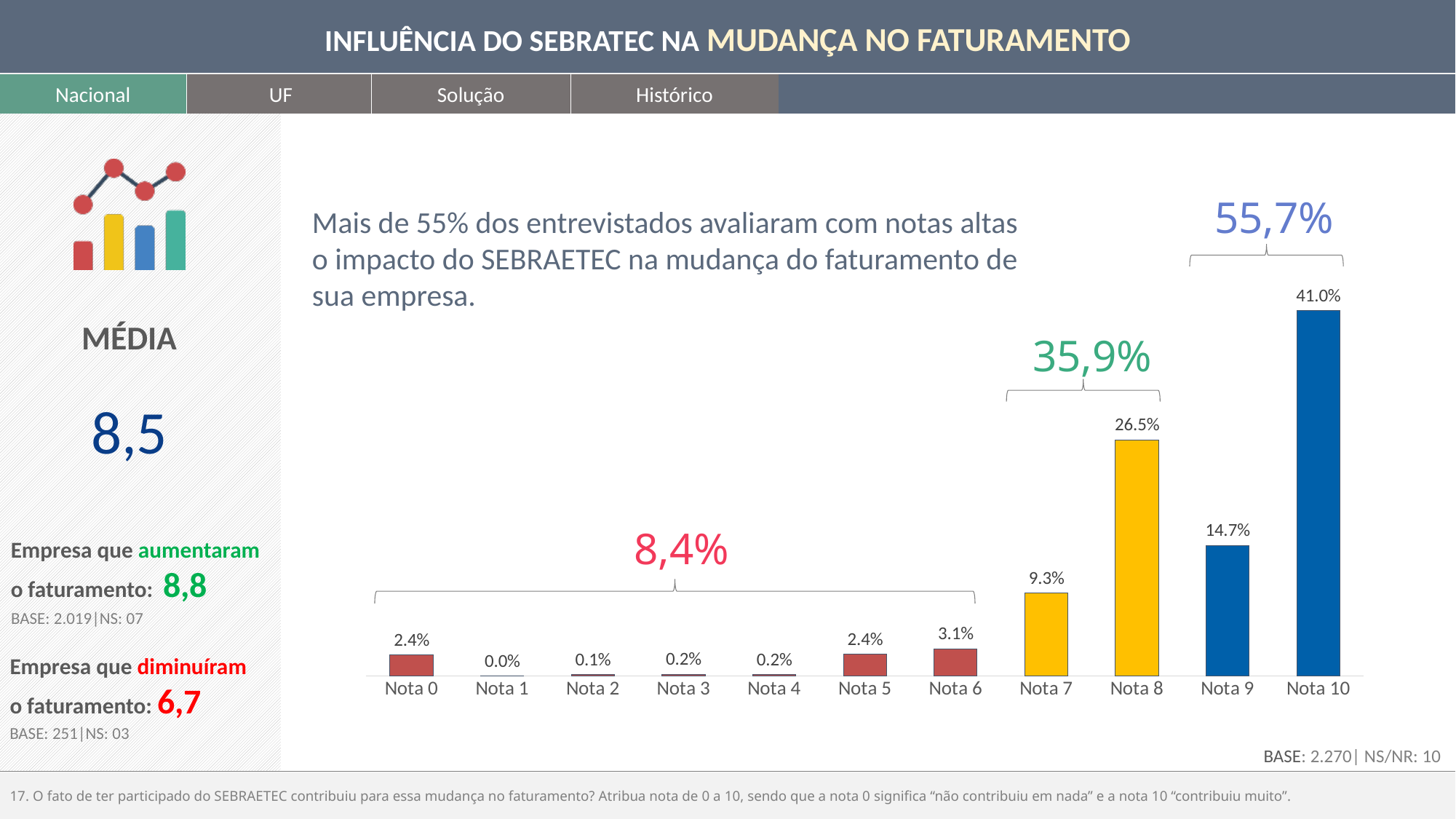
What combined percentage is shown above the bracket covering Nota 9 and Nota 10? 55,7% How many categories are shown on the x axis? 11 What is the value for Nota 7? 9.3% Which category has the lowest value? Nota 1 What combined percentage is shown above the bracket covering Nota 0 to Nota 6? 8,4% What is the difference between the values for Nota 10 and Nota 8? 14.5% Which is larger, the value for Nota 9 or the value for Nota 8? Nota 8 Which category has the highest value? Nota 10 What is the value for Nota 1? 0.0% What is the value for Nota 8? 26.5% What kind of chart is shown on the slide? Bar chart What is the value for Nota 10? 41.0%